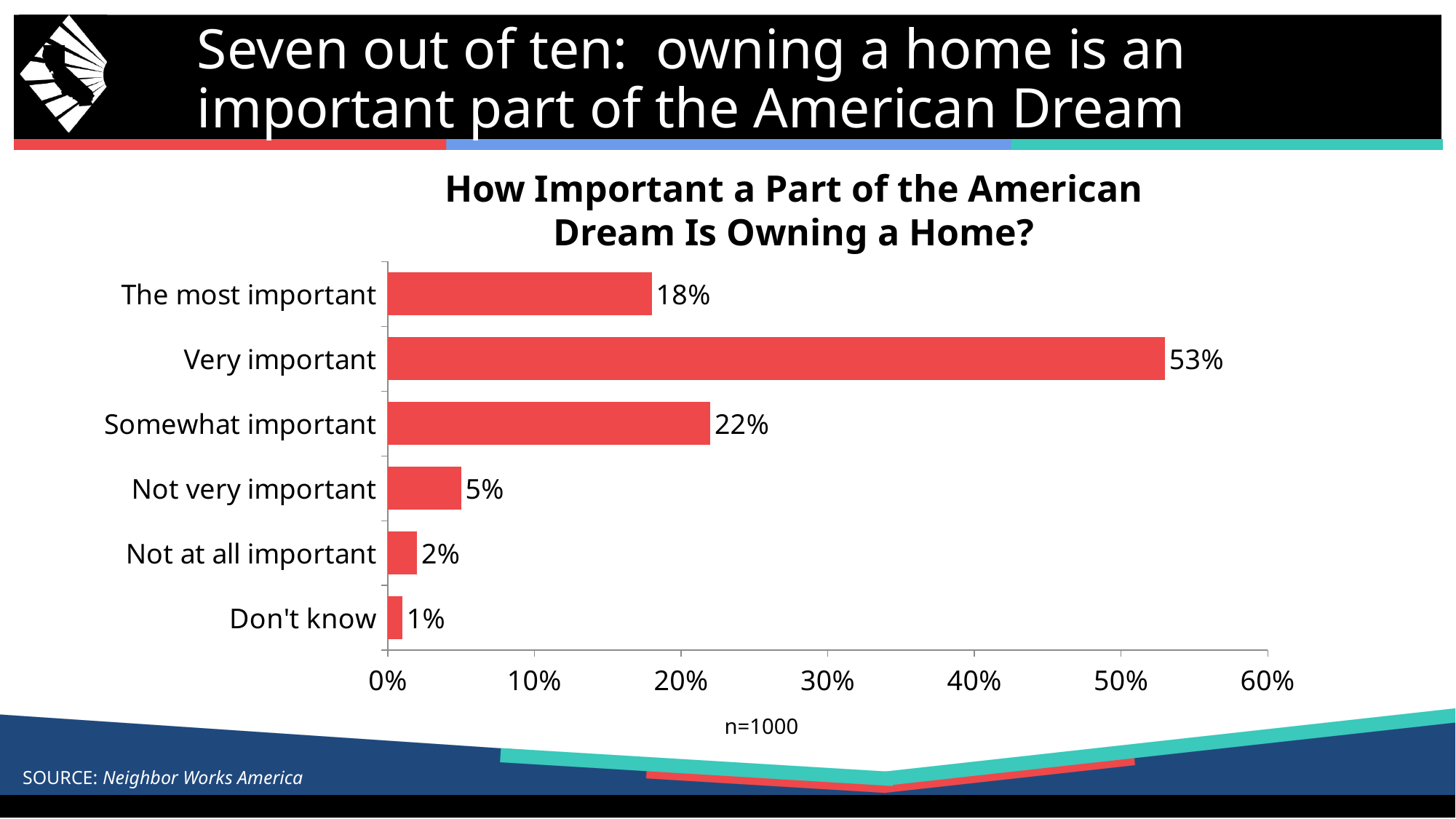
How many categories are shown in the chart? 6 What is the value for "Don't know"? 1% What is the difference between "Not very important" and "Not at all important"? 3% What is the difference between "Very important" and "Somewhat important"? 31% What kind of chart is shown on the slide? Bar chart Which is larger, "The most important" or "Somewhat important"? Somewhat important What percentage answered "Not very important"? 5% What is the title of the chart? How Important a Part of the American Dream Is Owning a Home? What is the value for "The most important"? 18% What percentage of respondents said owning a home is "Very important" to the American Dream? 53% Which category has the highest value? Very important Which category has the lowest value? Don't know